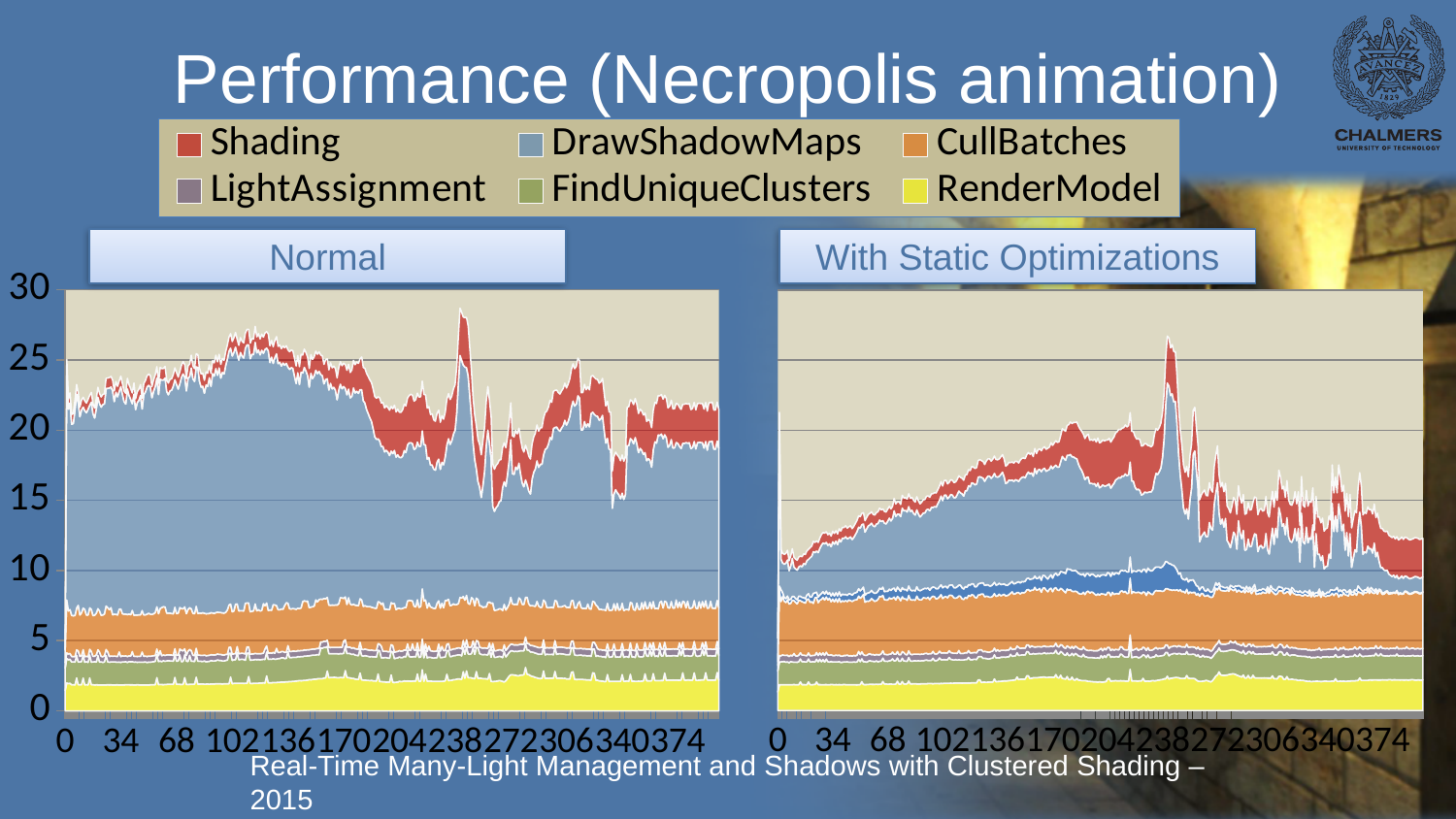
In the With Static Optimizations chart, does the total value rise or fall between x = 238 and x = 374? fall What kind of chart is the Normal chart? stacked area chart In the With Static Optimizations chart, does the total value rise or fall between x = 0 and x = 170? rise In the Normal chart, is the top of the RenderModel band greater or less than 5? less In the Normal chart, is the peak total value near x = 238 greater or less than 25? greater In the With Static Optimizations chart, is the total value at x = 374 greater or less than 15? less Which series is drawn at the bottom of the stack in both charts? RenderModel What colour represents Shading in the legend? red How many series does the legend list? 6